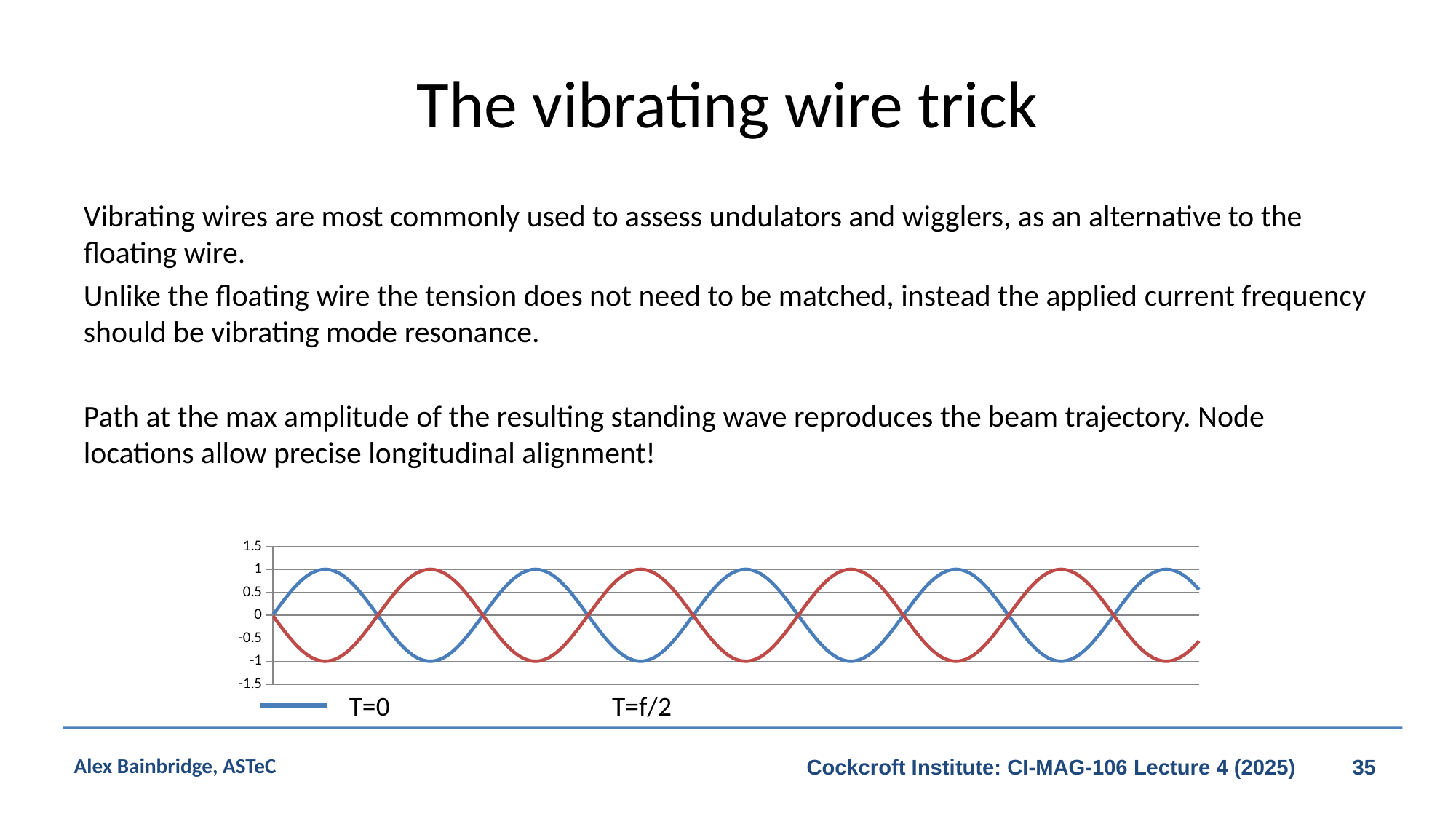
What is the lowest value labelled on the chart's vertical axis? -1.5 How many series does the chart legend list? 2 What is the maximum value reached by the T=f/2 line? 1 What is the highest value labelled on the chart's vertical axis? 1.5 What are the two series named in the chart legend? T=0 and T=f/2 Do the plotted values rise steadily, fall steadily, or oscillate along the x axis? oscillate What kind of chart is shown on the slide? line chart Is the peak value of the T=0 line greater or less than 1.5? less How many times does the blue T=0 line reach its peak value of 1 across the chart? 5 What is the maximum value reached by the T=0 line? 1 Is the lowest value of the T=f/2 line greater or less than -0.5? less What is the minimum value reached by the T=0 line? -1